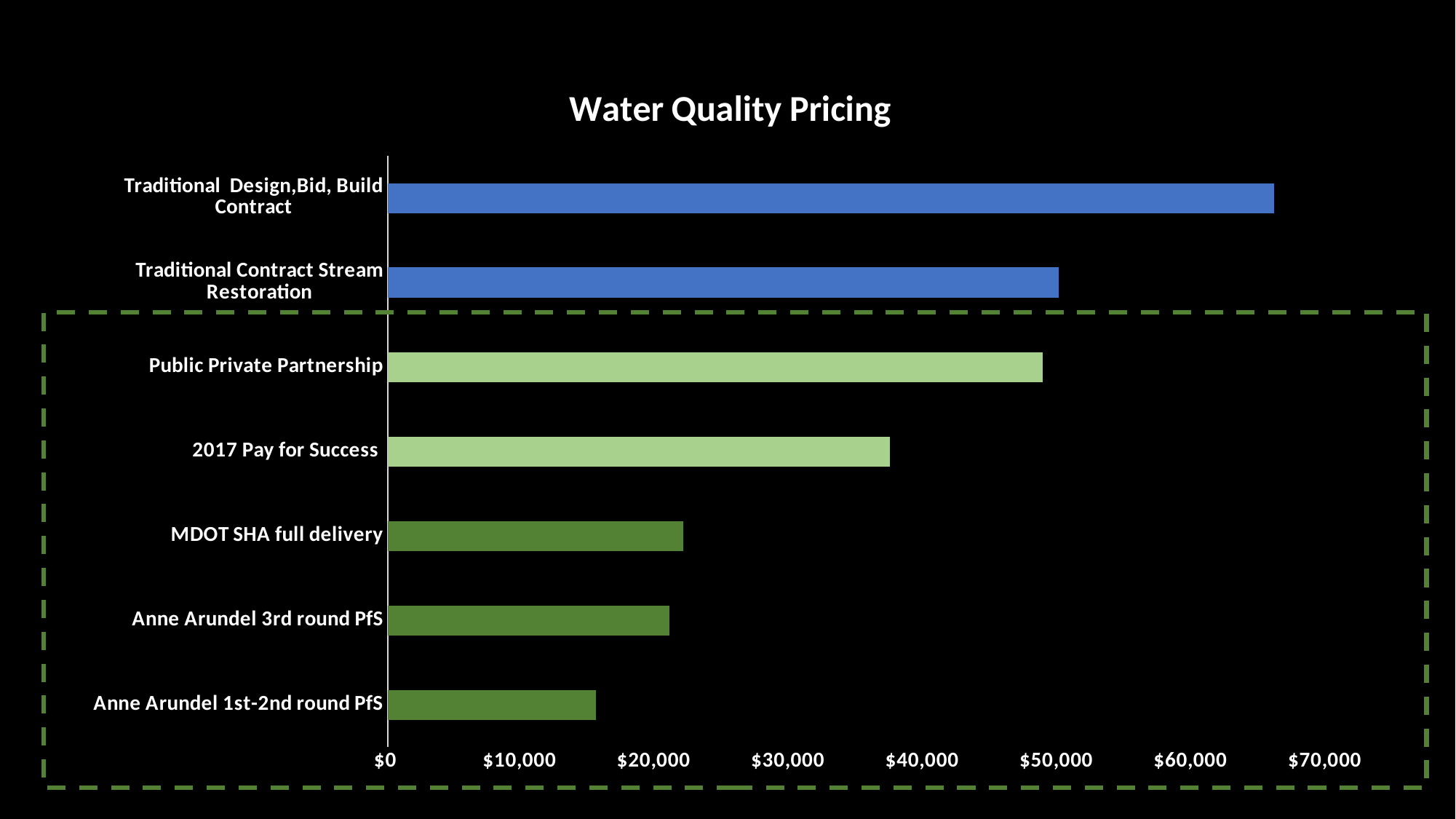
Is the value for Traditional Design,Bid, Build Contract greater or less than $60,000? greater Which is larger, the value for Traditional Design,Bid, Build Contract or the value for Public Private Partnership? Traditional Design,Bid, Build Contract How many categories are plotted in the chart? 7 Is the value for 2017 Pay for Success greater or less than $40,000? less What type of chart is shown on the slide? bar chart Is the value for Traditional Contract Stream Restoration greater or less than $40,000? greater Which category has the lowest value? Anne Arundel 1st-2nd round PfS Which is larger, the value for 2017 Pay for Success or the value for MDOT SHA full delivery? 2017 Pay for Success Which category has the highest value? Traditional Design,Bid, Build Contract What is the title of the chart? Water Quality Pricing